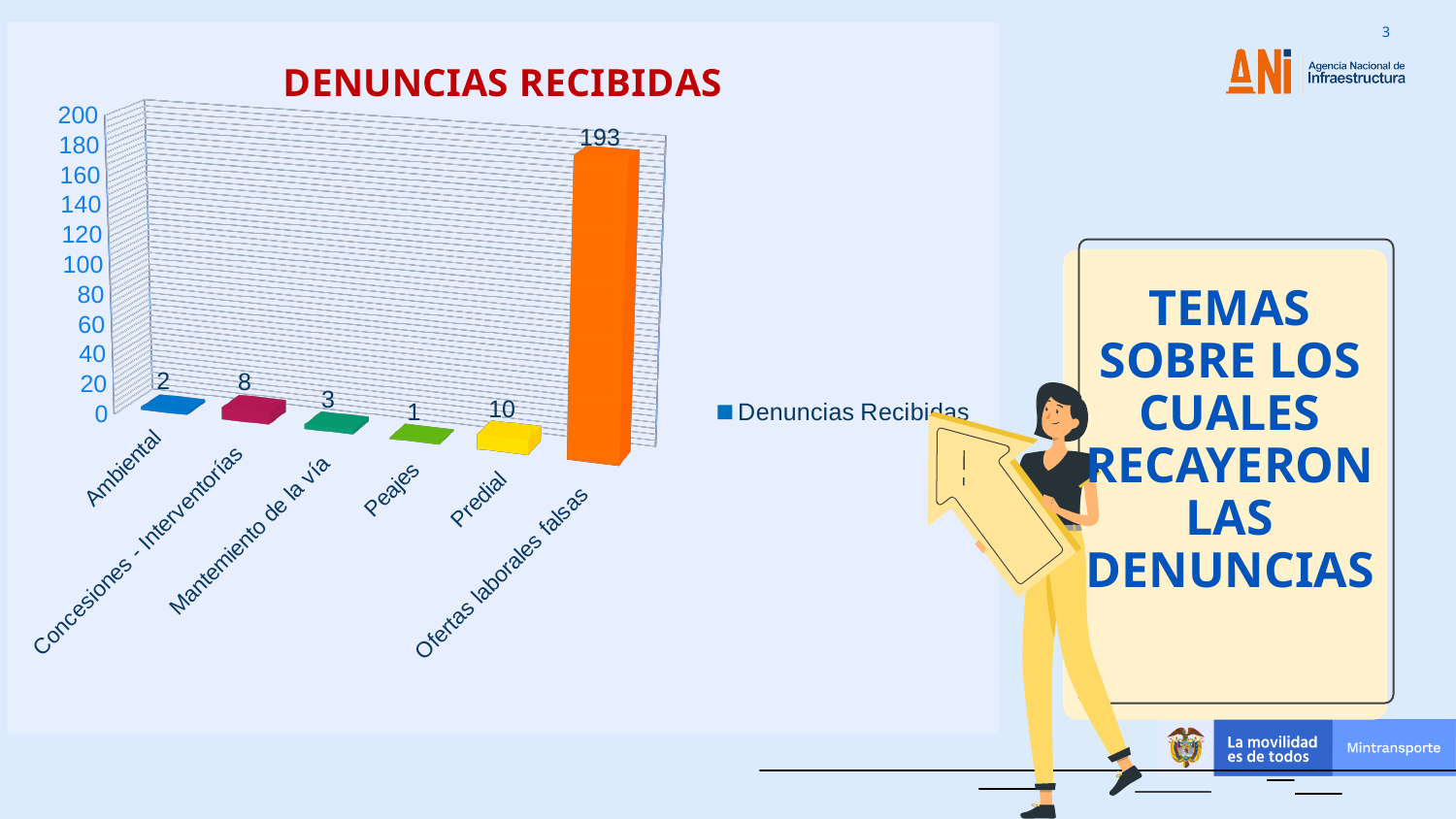
Is the value for Ofertas laborales falsas greater or less than 180? greater Which is larger, the value for Concesiones - Interventorías or the value for Mantemiento de la vía? Concesiones - Interventorías What is the value for Concesiones - Interventorías? 8 What is the value for Predial? 10 Which category has the highest value? Ofertas laborales falsas What is the value for Ambiental? 2 How many categories are shown on the x axis? 6 What is the value for Ofertas laborales falsas? 193 What is the difference between the values for Ofertas laborales falsas and Predial? 183 What is the title of the chart? DENUNCIAS RECIBIDAS What kind of chart is shown? bar chart Which category has the lowest value? Peajes